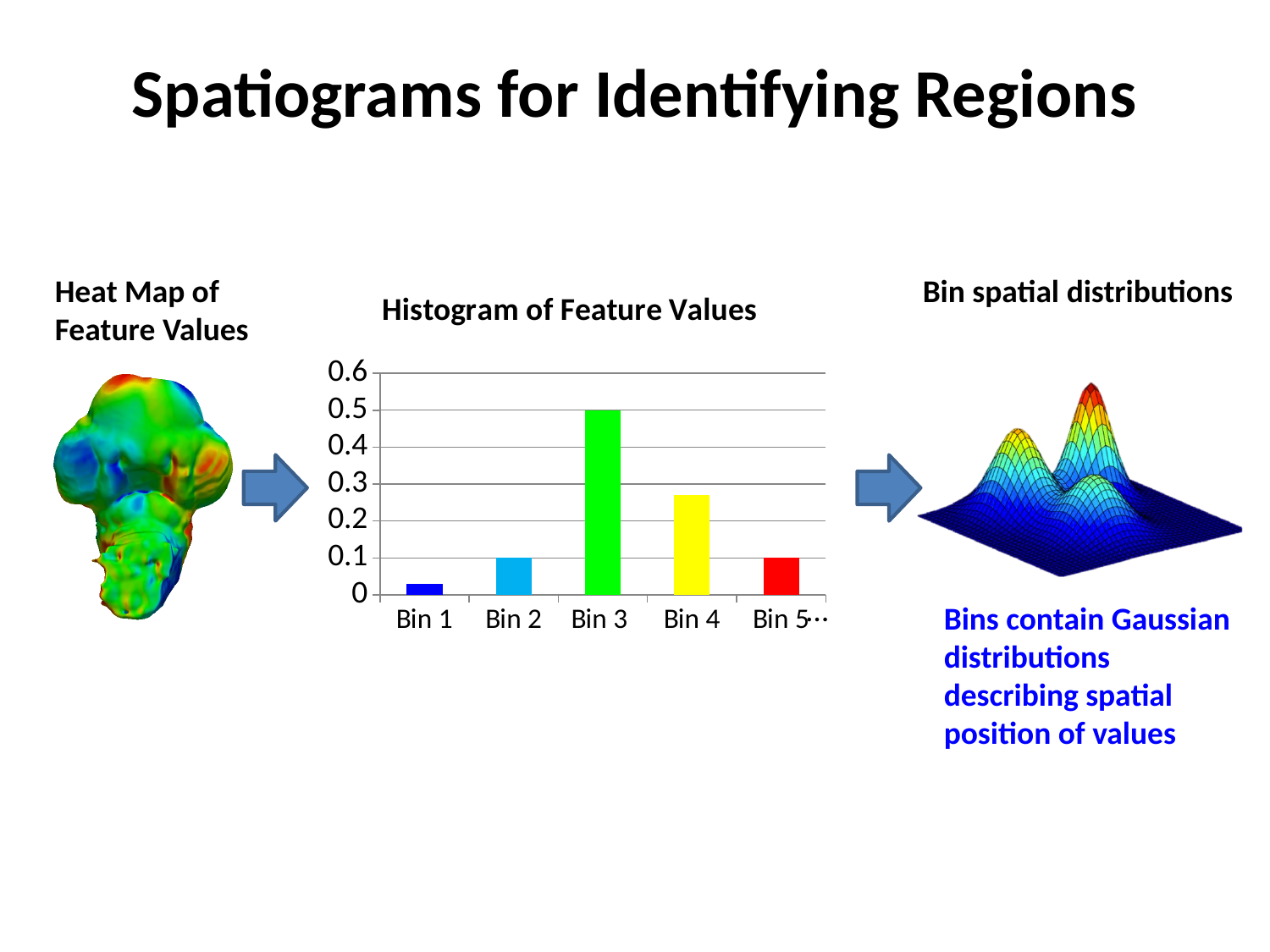
In the Histogram of Feature Values, which is larger, the value for Bin 4 or the value for Bin 2? Bin 4 What is the title of the bar chart in the middle of the slide? Histogram of Feature Values In the Histogram of Feature Values, which bin has the lowest value? Bin 1 In the Histogram of Feature Values, what is the value for Bin 3? 0.5 How many bins are shown on the x axis of the Histogram of Feature Values chart? 5 In the Histogram of Feature Values, what is the value for Bin 2? 0.1 In the Histogram of Feature Values, which bin has the highest value? Bin 3 What kind of chart is the Histogram of Feature Values? bar chart In the Histogram of Feature Values, what is the value for Bin 5? 0.1 In the Histogram of Feature Values, is the value for Bin 4 greater or less than 0.2? greater In the Histogram of Feature Values, is the value for Bin 1 greater or less than 0.1? less In the Histogram of Feature Values, what is the difference between the values for Bin 3 and Bin 2? 0.4